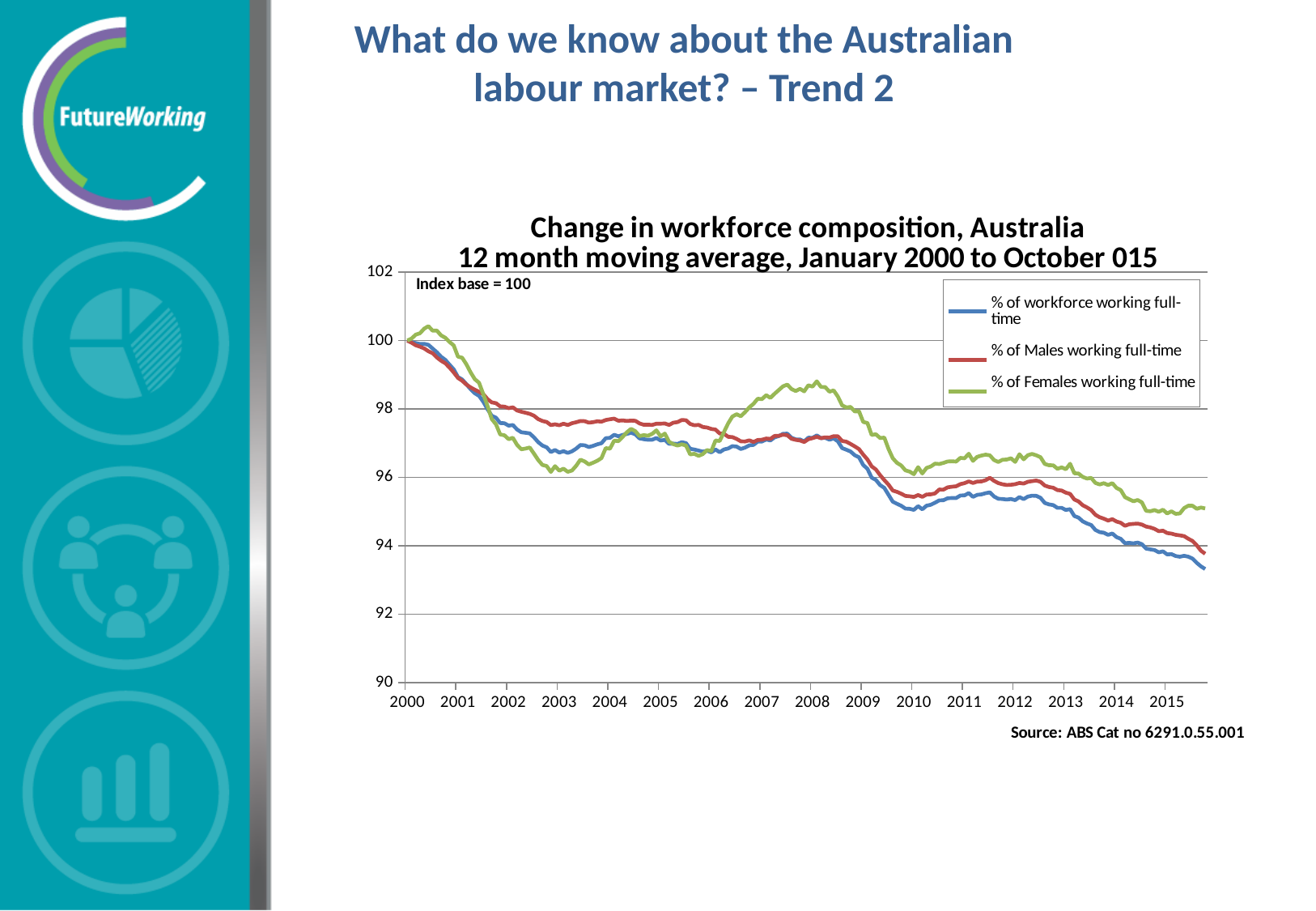
Is the value for % of workforce working full-time at the end of 2015 greater or less than 94? less Overall, do the plotted lines rise or fall from 2000 to 2015? fall Around 2003, which is higher: % of Males working full-time or % of Females working full-time? % of Males working full-time Is the value for % of Females working full-time at its 2008 peak greater or less than 98? greater Around 2008, which is higher: % of Females working full-time or % of Males working full-time? % of Females working full-time Which series is lowest at the end of the chart in 2015? % of workforce working full-time What index base does the chart state? Index base = 100 What kind of chart is shown on the slide? line chart What is the title of the chart? Change in workforce composition, Australia 12 month moving average, January 2000 to October 015 How many series does the legend list? 3 Is the value for % of Females working full-time at the end of 2015 greater or less than 94? greater Which series is highest at the end of the chart in 2015? % of Females working full-time